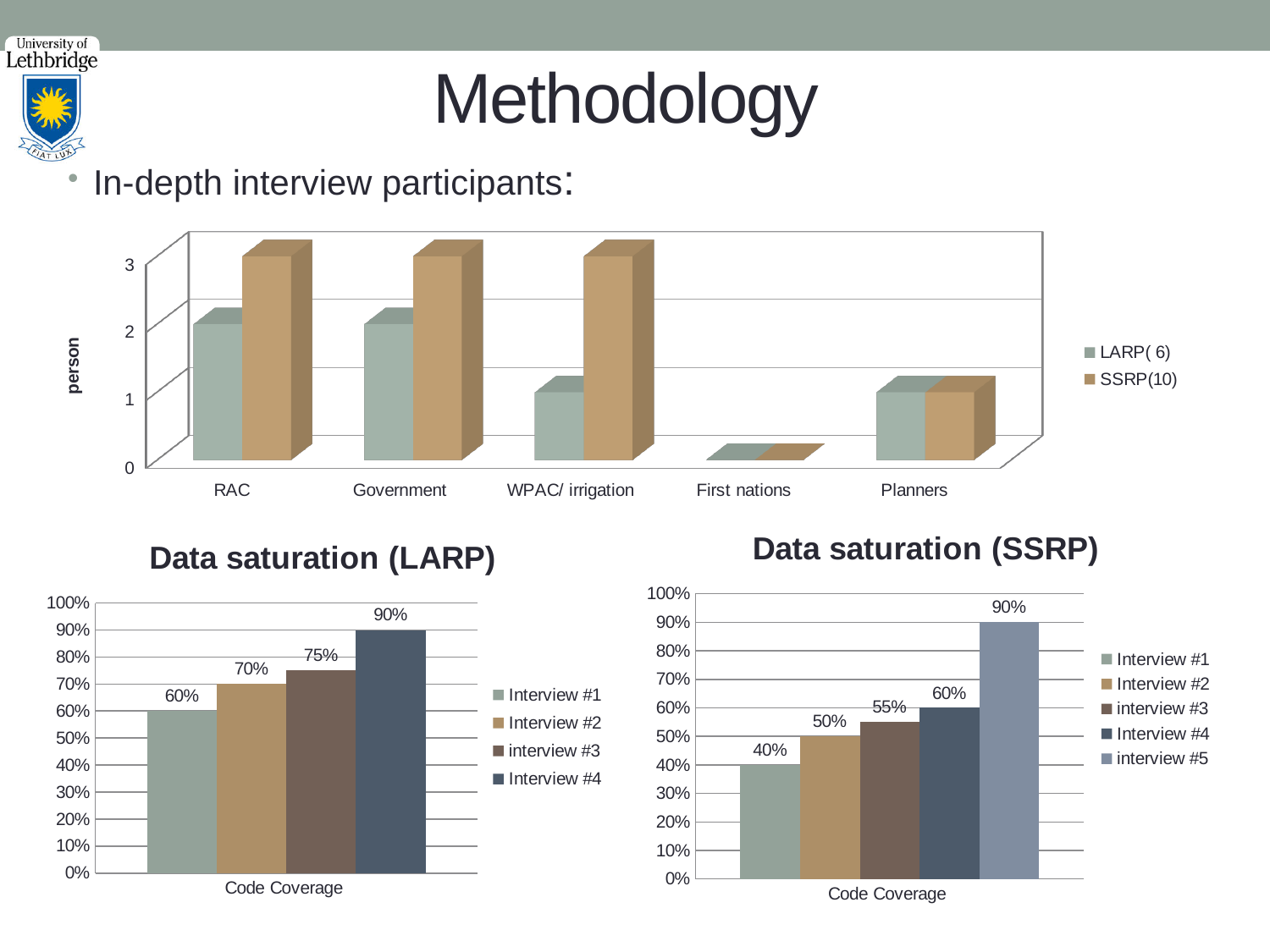
In the Data saturation (SSRP) chart, which interview has the highest value? interview #5 In the Data saturation (LARP) chart, do the values rise or fall from Interview #1 to Interview #4? rise In the top chart of interview participants, is the SSRP(10) value for RAC greater or less than 2? greater In the Data saturation (LARP) chart, what is the value for Interview #2? 70% In the Data saturation (SSRP) chart, which is larger, Interview #2 or interview #3? interview #3 In the Data saturation (LARP) chart, which interview has the lowest value? Interview #1 What kind of chart is the Data saturation (LARP) chart? bar chart In the Data saturation (LARP) chart, what is the difference between Interview #4 and Interview #1? 30% In the Data saturation (SSRP) chart, how many series does the legend list? 5 In the Data saturation (SSRP) chart, what is the value for Interview #1? 40% In the top chart of interview participants, how many categories are shown on the x axis? 5 In the Data saturation (SSRP) chart, what is the difference between interview #5 and Interview #4? 30%